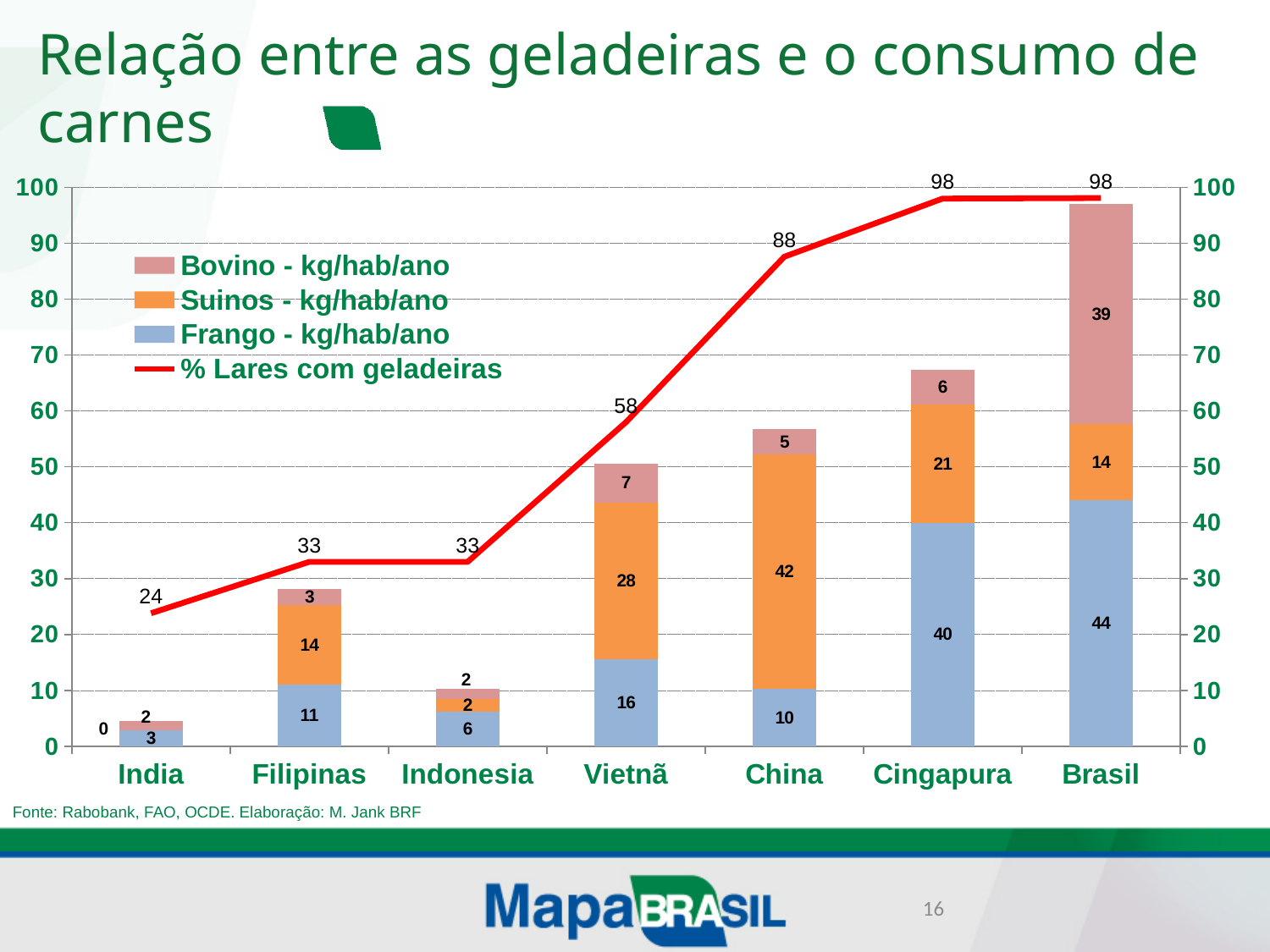
Which country has the lowest % Lares com geladeiras value? India What is the Bovino - kg/hab/ano value for Cingapura? 6 What is the Frango - kg/hab/ano value for Brasil? 44 What is the Suinos - kg/hab/ano value for China? 42 Which is larger, the Frango - kg/hab/ano value for Cingapura or for China? Cingapura What is the % Lares com geladeiras value for Vietnã? 58 How many countries are shown on the x axis? 7 Does the % Lares com geladeiras line rise or fall from India to Brasil? rise What is the total of the stacked bar for Vietnã? 51 How many series does the legend list? 4 What is the difference between the Suinos - kg/hab/ano values for China and Vietnã? 14 Which country has the highest Bovino - kg/hab/ano value? Brasil